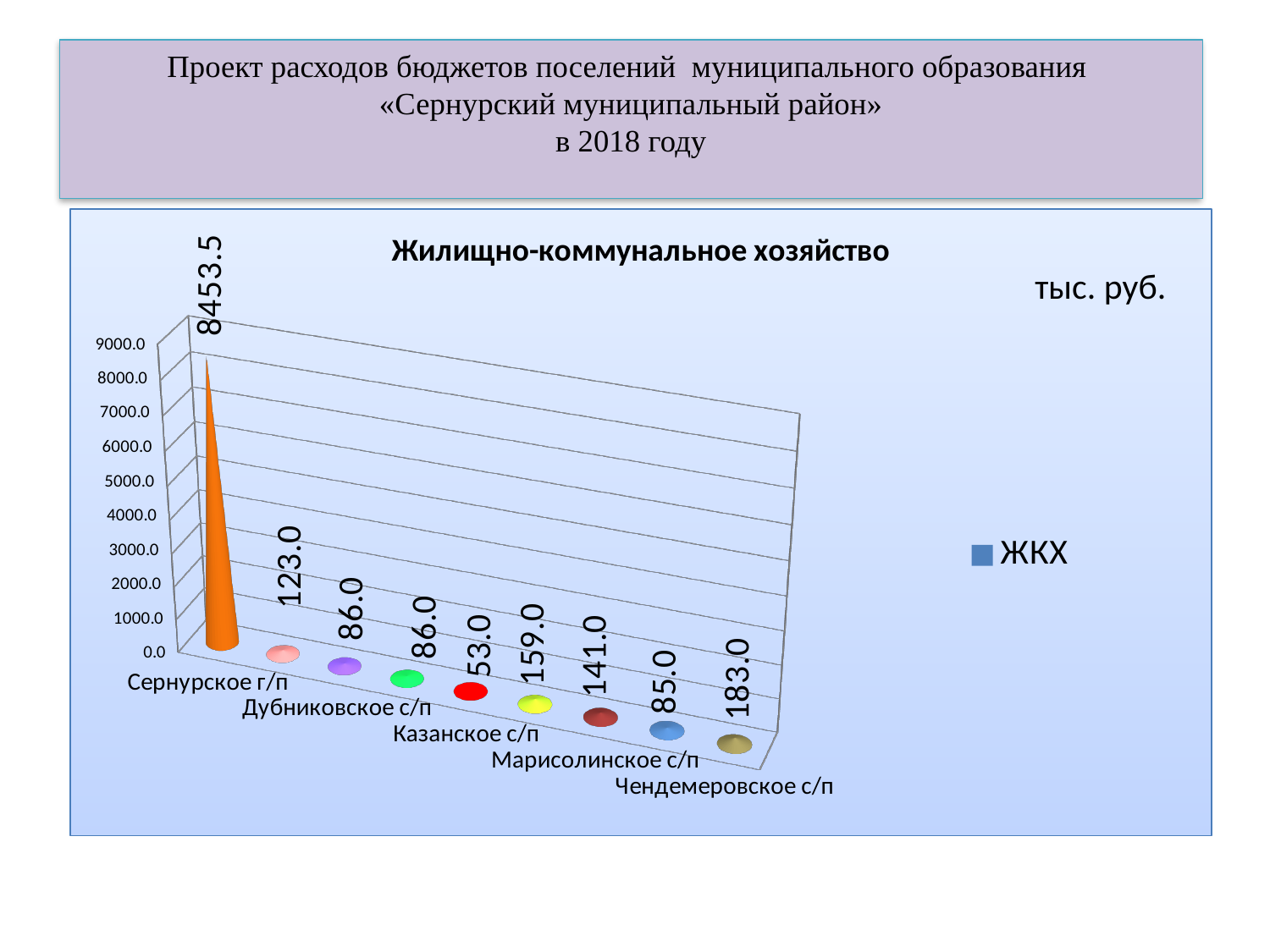
Which category has the highest value? Сернурское г/п Is the value for Сернурское г/п greater or less than 8000.0? greater What is the title of the chart? Жилищно-коммунальное хозяйство Which is larger, the value for Марисолинское с/п or the value for Казанское с/п? Марисолинское с/п What is the value for Марисолинское с/п? 141.0 What is the value for Чендемеровское с/п? 183.0 What is the lowest value shown on the chart? 53.0 What is the value for Сернурское г/п? 8453.5 What is the value for Казанское с/п? 53.0 What is the value for Дубниковское с/п? 86.0 How many categories are plotted on the chart? 9 What is the difference between the values for Чендемеровское с/п and Дубниковское с/п? 97.0